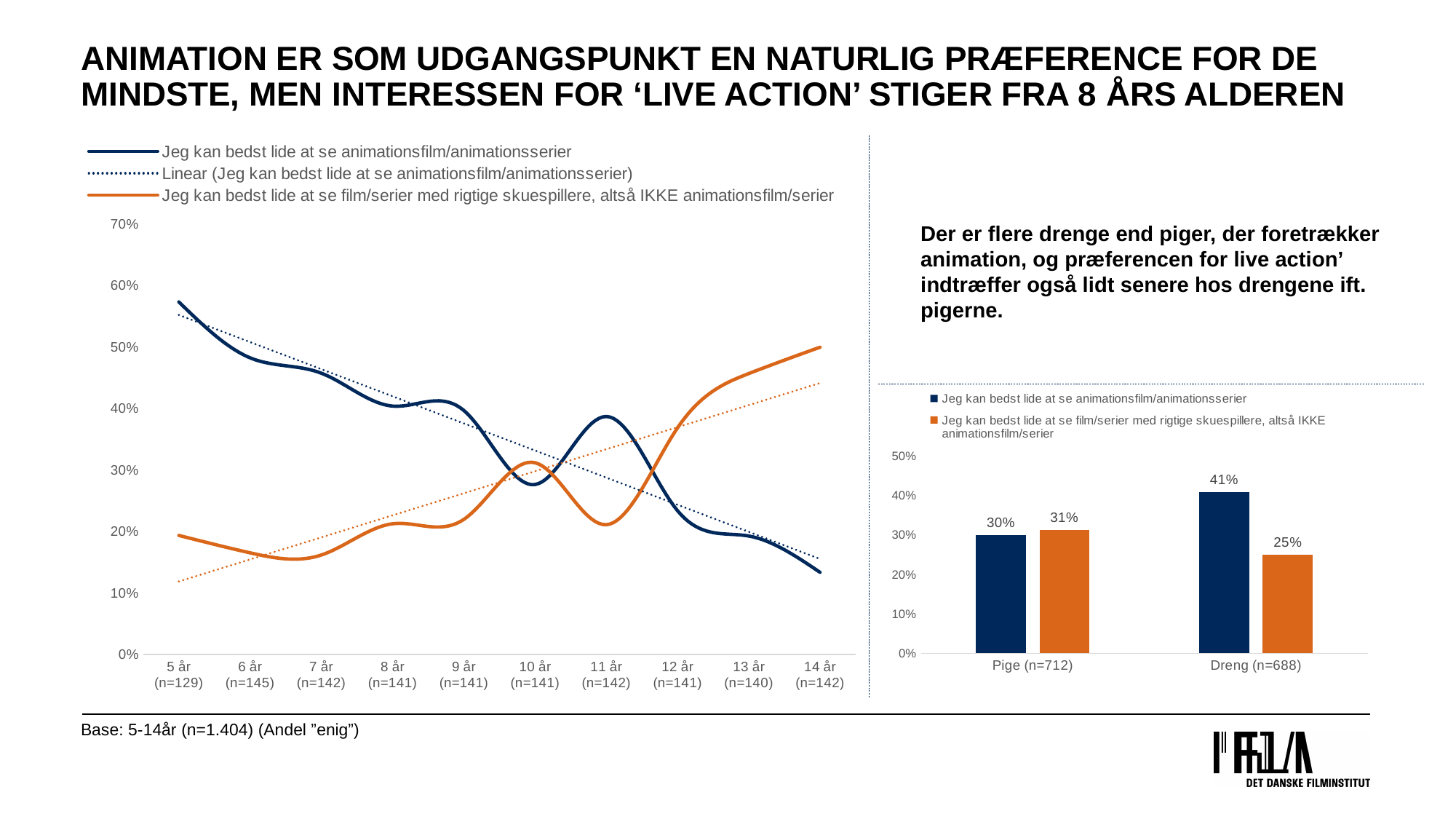
In the left-hand line chart, is the value for 'Jeg kan bedst lide at se animationsfilm/animationsserier' at 14 år greater or less than 20%? less In the right-hand bar chart, what percentage of Pige (n=712) prefer animationsfilm/animationsserier? 30% In the right-hand bar chart, what is the value for Dreng (n=688) for 'Jeg kan bedst lide at se animationsfilm/animationsserier'? 41% How many age categories are shown on the x axis of the left-hand line chart? 10 In the left-hand line chart, is the value for 'Jeg kan bedst lide at se film/serier med rigtige skuespillere' at 13 år greater or less than 40%? greater In the right-hand bar chart, what is the difference between the two bars for Dreng (n=688)? 16 percentage points In the right-hand bar chart, which bar has the highest value? Dreng (n=688), animationsfilm/animationsserier (41%) In the right-hand bar chart, which group has the larger share preferring animationsfilm/animationsserier, Pige or Dreng? Dreng (n=688) In the right-hand bar chart, what percentage of Dreng (n=688) prefer film/serier med rigtige skuespillere? 25% In the left-hand line chart, does the line for 'Jeg kan bedst lide at se animationsfilm/animationsserier' rise or fall from 5 år to 14 år? Fall What kind of chart is shown on the right side of the slide? Bar chart How many series does the legend of the right-hand bar chart list? 2